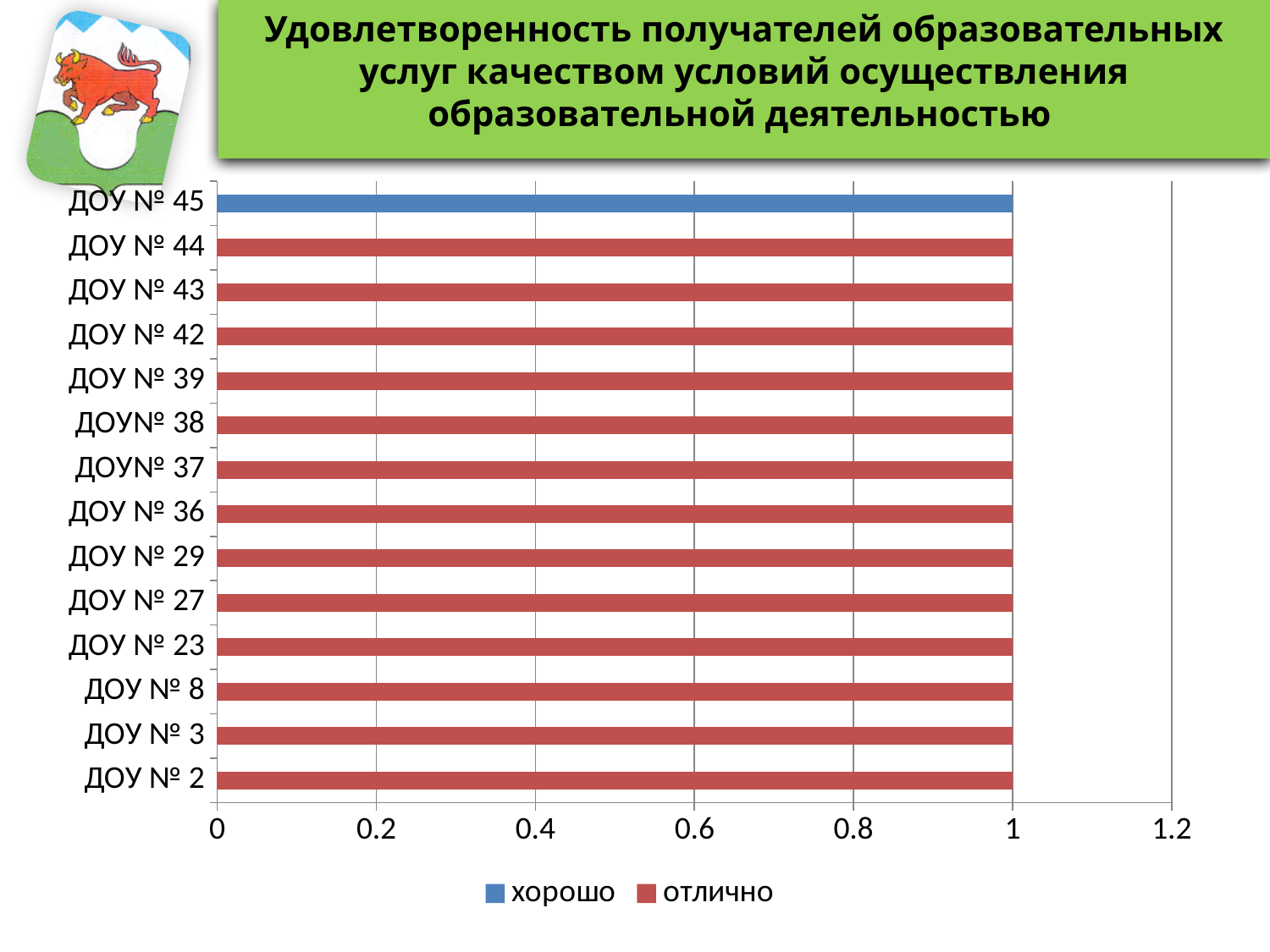
Which category is the only one plotted in the 'хорошо' series (blue bar)? ДОУ № 45 Is the value for ДОУ № 44 greater or less than 1.2? less What is the difference between the values for ДОУ № 44 and ДОУ № 3? 0 What are the two series named in the chart legend? хорошо, отлично How many series does the chart legend list? 2 What is the value of the bar for ДОУ № 2? 1 What is the value of the bar for ДОУ № 45? 1 What kind of chart is shown on the slide? bar chart How many categories (ДОУ) are listed on the vertical axis of the chart? 14 What is the highest tick value shown on the horizontal axis? 1.2 What is the value of the bar for ДОУ № 36? 1 Is the value for ДОУ № 23 greater or less than 0.8? greater